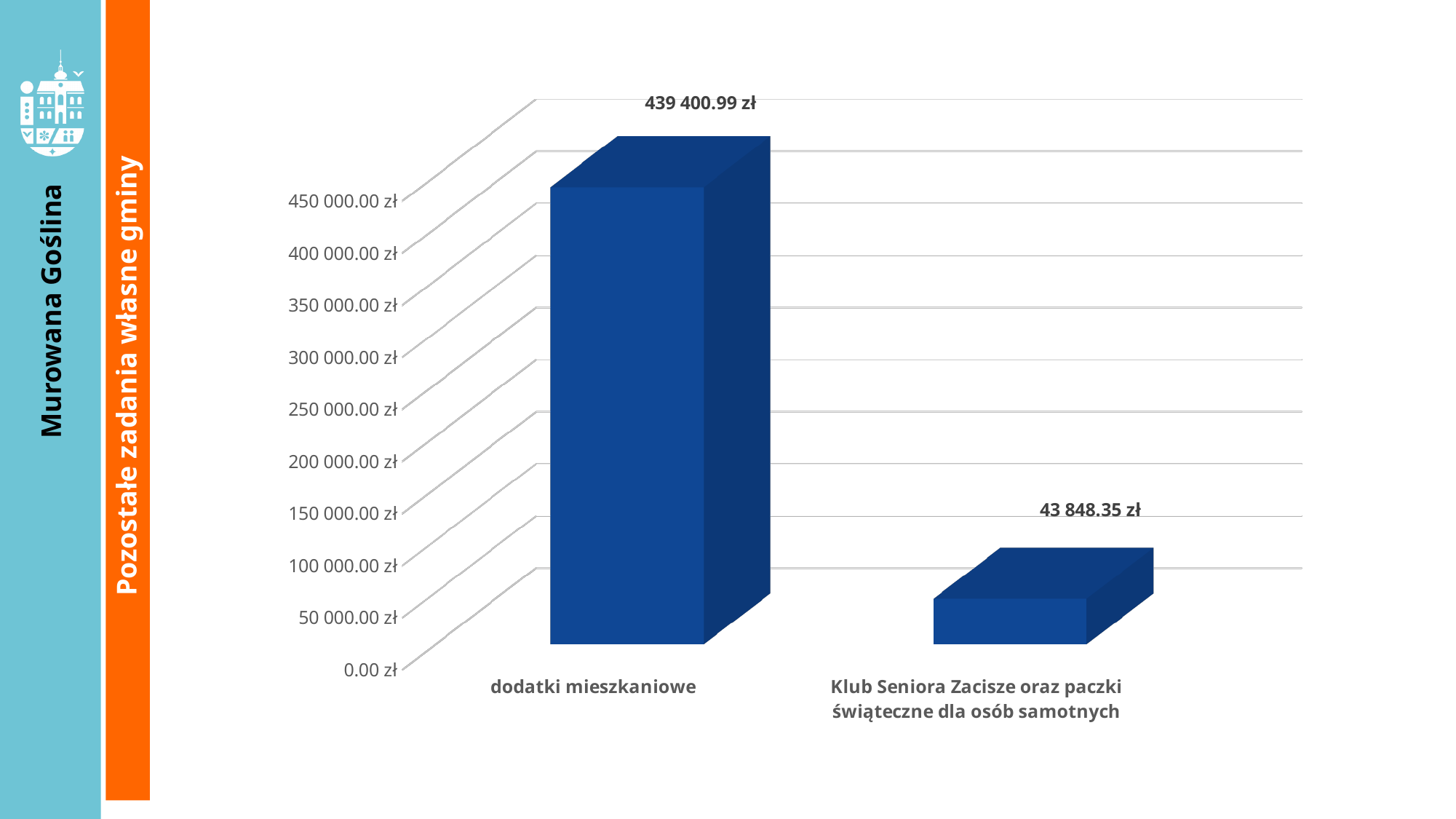
What is the difference between the value for dodatki mieszkaniowe and the value for Klub Seniora Zacisze oraz paczki świąteczne dla osób samotnych? 395 552.64 zł Which category has the lowest value? Klub Seniora Zacisze oraz paczki świąteczne dla osób samotnych Is the value for Klub Seniora Zacisze oraz paczki świąteczne dla osób samotnych greater or less than 50 000.00 zł? less How many categories are shown in the chart? 2 What is the title shown on the orange band of the slide? Pozostałe zadania własne gminy Which is larger: the value for dodatki mieszkaniowe or the value for Klub Seniora Zacisze oraz paczki świąteczne dla osób samotnych? dodatki mieszkaniowe What kind of chart is shown on the slide? bar chart What is the value for dodatki mieszkaniowe? 439 400.99 zł Which category has the highest value? dodatki mieszkaniowe What is the value for Klub Seniora Zacisze oraz paczki świąteczne dla osób samotnych? 43 848.35 zł What is the highest value labelled on the vertical axis? 450 000.00 zł Is the value for dodatki mieszkaniowe greater or less than 400 000.00 zł? greater